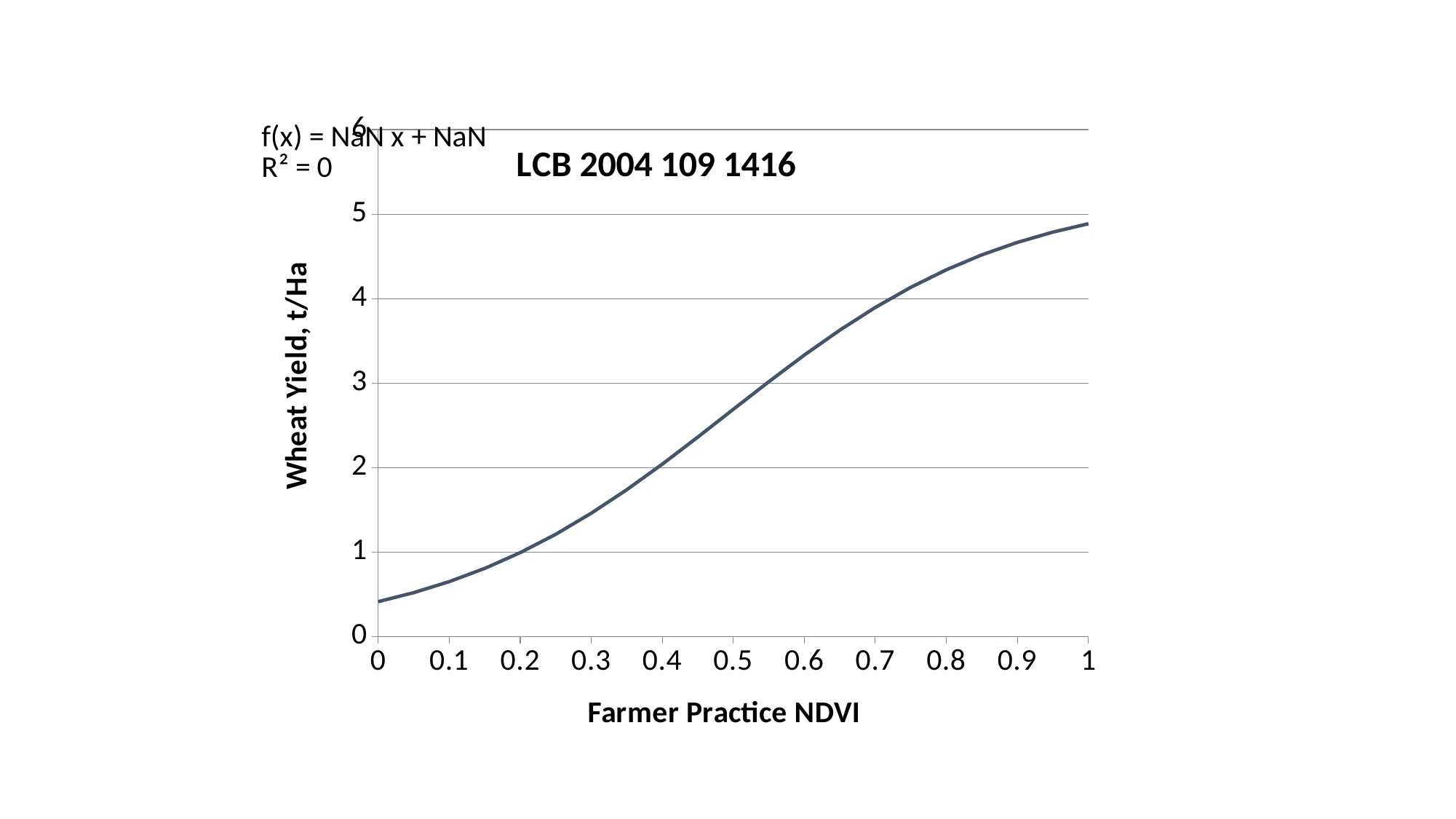
Is the wheat yield at Farmer Practice NDVI 0.6 greater or less than 3? greater Is the wheat yield at Farmer Practice NDVI 0.8 greater or less than 4? greater At which Farmer Practice NDVI value shown on the x axis is wheat yield highest? 1 What is the label of the y axis? Wheat Yield, t/Ha Is the wheat yield at Farmer Practice NDVI 0.3 greater or less than 1? greater Does wheat yield rise or fall as Farmer Practice NDVI increases from 0 to 1? rise Which has the higher wheat yield: Farmer Practice NDVI 0.2 or 0.8? 0.8 What kind of chart is shown on the slide? line chart What is the title of the chart? LCB 2004 109 1416 At which Farmer Practice NDVI value shown on the x axis is wheat yield lowest? 0